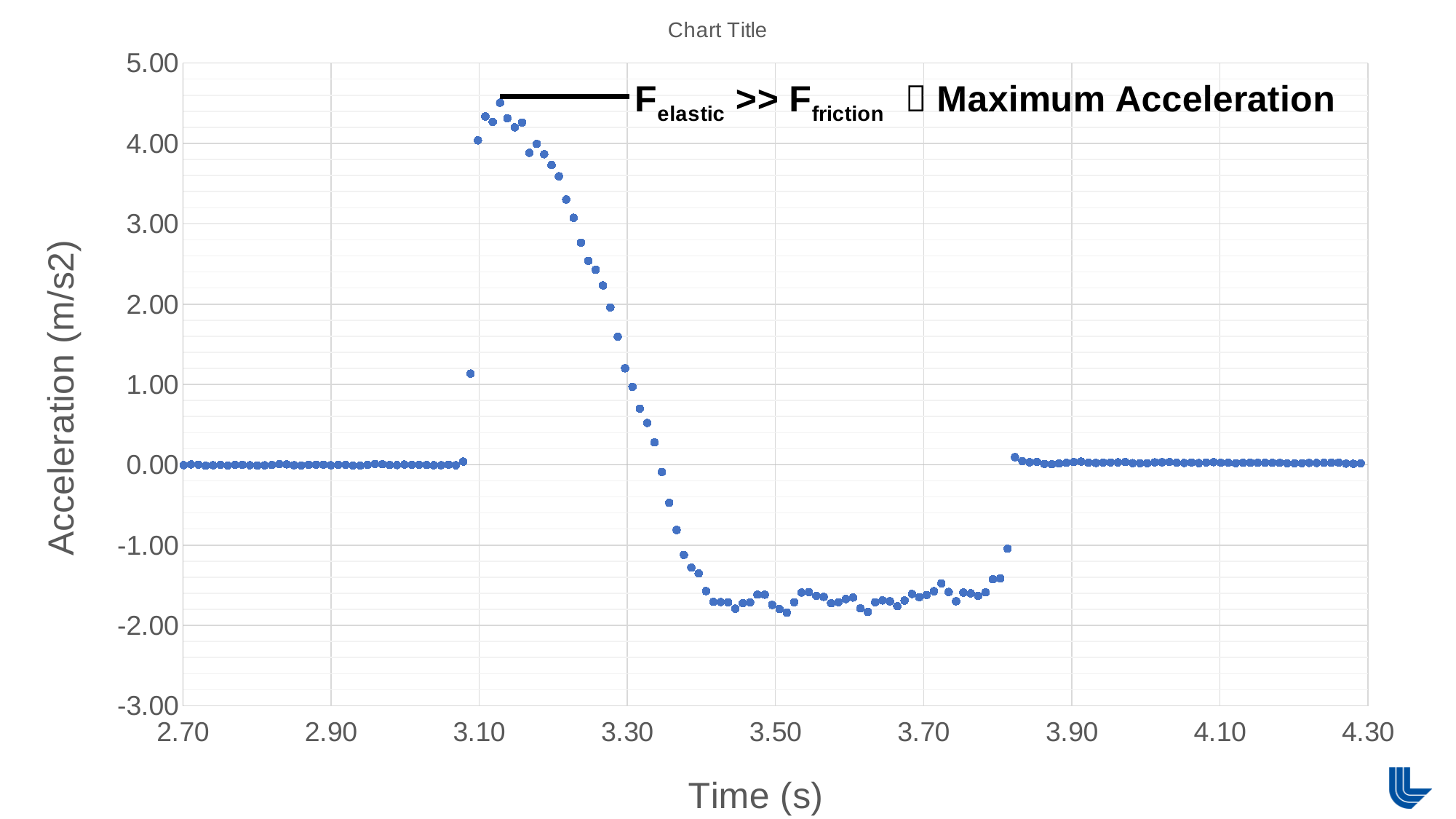
Is the acceleration at time 3.20 s greater or less than 3.00? greater Is the peak acceleration value on the chart greater or less than 4.00? greater Is the lowest acceleration value on the chart greater or less than -1.00? less What is the title of the chart's horizontal axis? Time (s) Between time 3.15 s and 3.40 s, do the acceleration values rise or fall? fall What is the title of the chart's vertical axis? Acceleration (m/s2) Which is larger, the acceleration at time 3.20 s or the acceleration at time 3.60 s? 3.20 s Which is larger, the acceleration at time 3.30 s or the acceleration at time 3.10 s? 3.10 s What kind of chart is shown on the slide? scatter chart